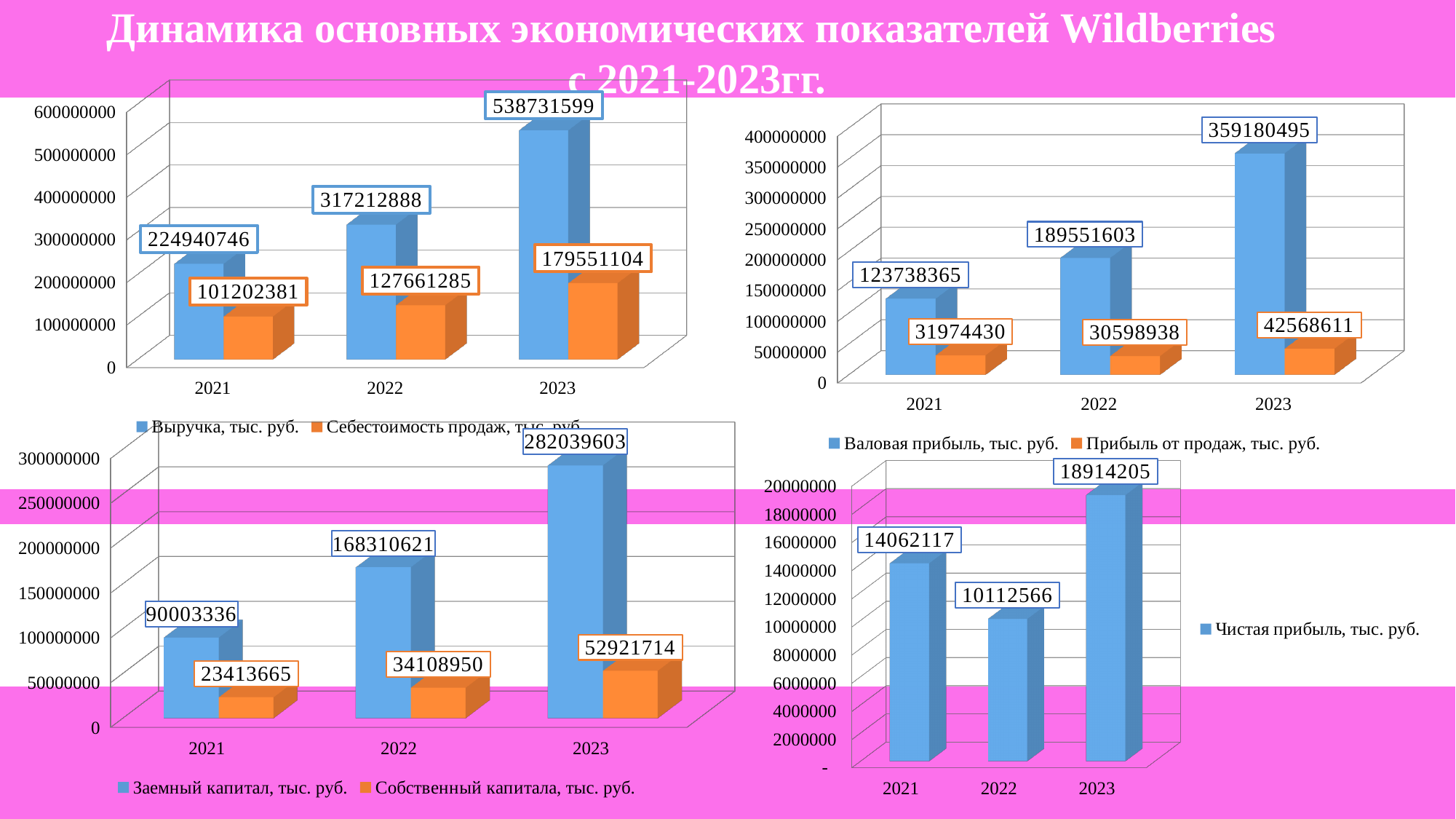
In the top-right chart, which year has the lowest Прибыль от продаж, тыс. руб.? 2022 In the top-left chart, what is the value of Выручка, тыс. руб. for 2023? 538731599 In the bottom-right chart, what is the value of Чистая прибыль, тыс. руб. for 2022? 10112566 In the top-left chart, what is the difference between Выручка and Себестоимость продаж in 2022? 189551603 In the bottom-left chart, what is the value of Заемный капитал, тыс. руб. for 2023? 282039603 In the top-right chart, which year has the highest Валовая прибыль, тыс. руб.? 2023 In the top-right chart, what is the value of Валовая прибыль, тыс. руб. for 2021? 123738365 What type of chart is the bottom-right chart? Bar chart In the top-left chart, what is the value of Себестоимость продаж, тыс. руб. for 2021? 101202381 In the bottom-left chart, which is larger in 2022: Заемный капитал or Собственный капитала? Заемный капитал In the bottom-right chart, what is the difference in Чистая прибыль between 2023 and 2021? 4852088 How many series does the legend of the bottom-left chart list? 2